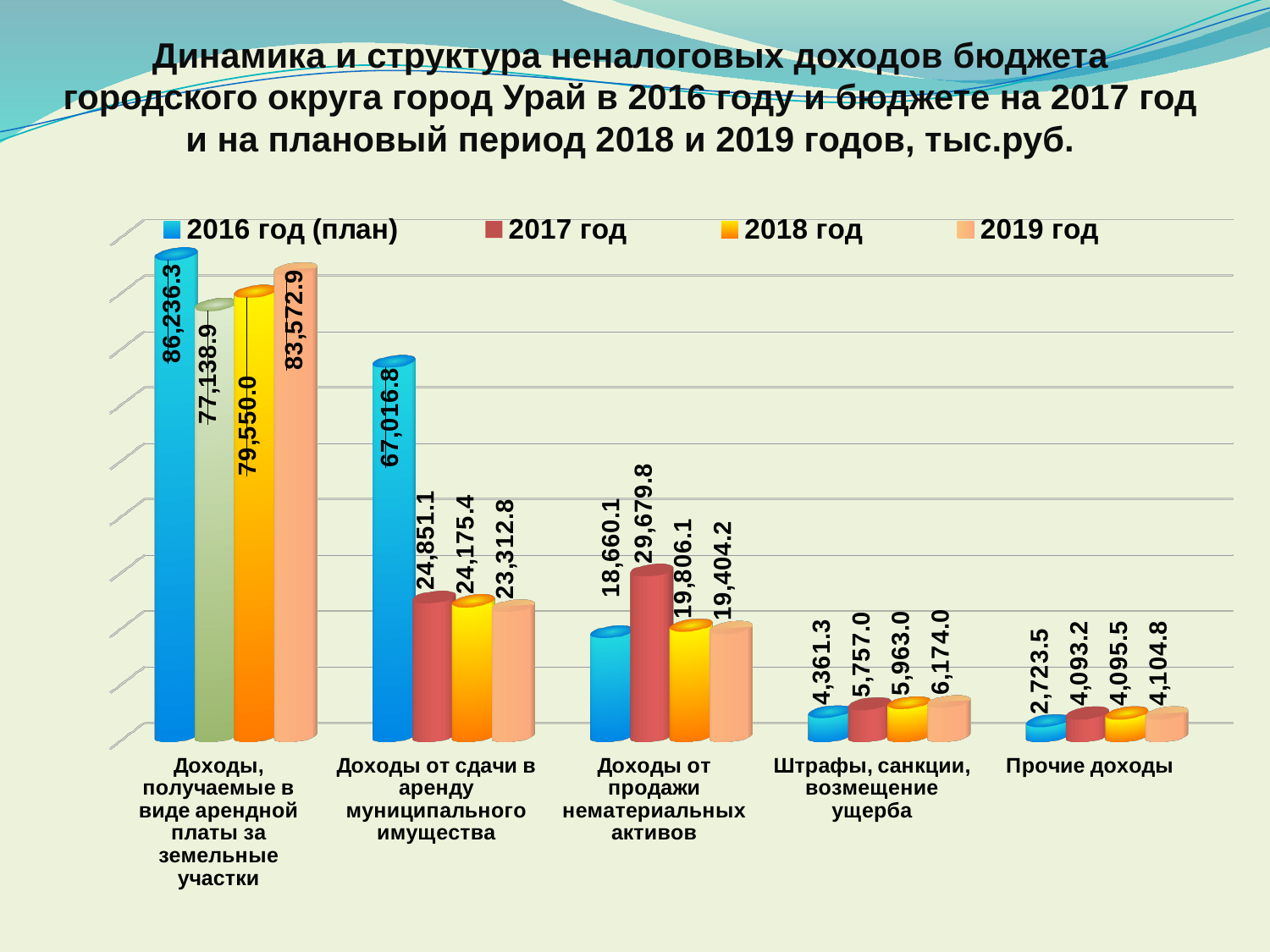
Which category has the highest value for 2016 год (план)? Доходы, получаемые в виде арендной платы за земельные участки How many series does the legend list? 4 In the category 'Доходы от продажи нематериальных активов', which is larger: the value for 2016 год (план) or for 2017 год? 2017 год What is the value for 2016 год (план) in the category 'Доходы, получаемые в виде арендной платы за земельные участки'? 86,236.3 What type of chart is shown on the slide? Bar chart Which category has the lowest value for 2017 год? Прочие доходы What is the value for 2019 год in the category 'Прочие доходы'? 4,104.8 What is the difference between the 2016 год (план) and 2017 год values in the category 'Доходы от сдачи в аренду муниципального имущества'? 42,165.7 Which series is listed first in the legend? 2016 год (план) What is the value for 2017 год in the category 'Доходы от продажи нематериальных активов'? 29,679.8 How many categories are shown on the x axis? 5 What is the value for 2018 год in the category 'Штрафы, санкции, возмещение ущерба'? 5,963.0